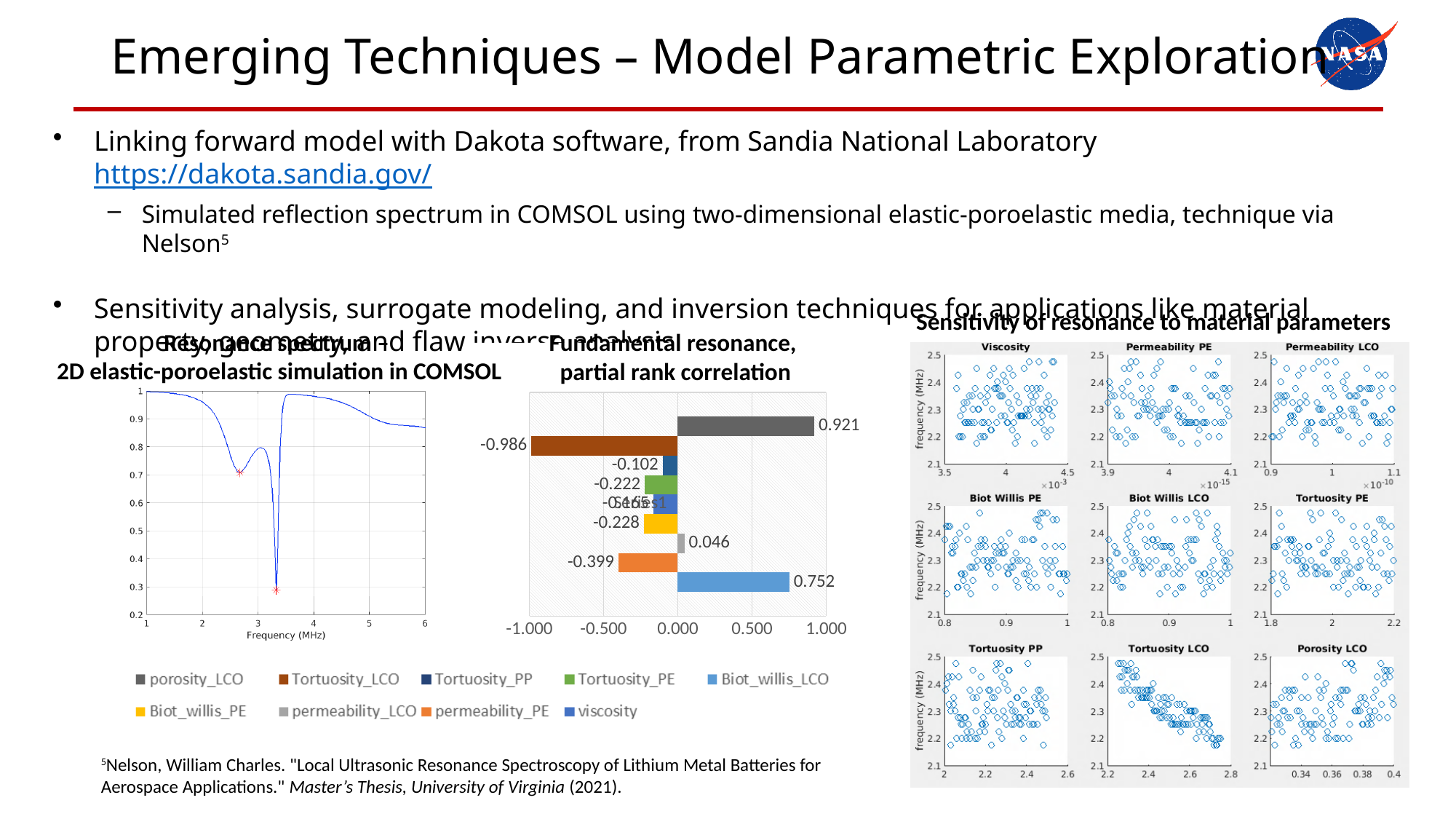
How many series does the legend of the 'Fundamental resonance, partial rank correlation' chart list? 9 In the 'Fundamental resonance, partial rank correlation' chart, which series has the highest value? porosity_LCO In the 'Sensitivity of resonance to material parameters' panel, how many scatter plots are shown? 9 In the 'Fundamental resonance, partial rank correlation' chart, which is larger: the value for Tortuosity_PP or the value for permeability_PE? Tortuosity_PP In the 'Fundamental resonance, partial rank correlation' chart, what is the value for permeability_LCO? 0.046 In the 'Fundamental resonance, partial rank correlation' chart, what is the value for porosity_LCO? 0.921 In the 'Fundamental resonance, partial rank correlation' chart, what is the value for permeability_PE? -0.399 In the 'Fundamental resonance, partial rank correlation' chart, what is the difference between the values for porosity_LCO and Biot_willis_LCO? 1.086 In the 'Fundamental resonance, partial rank correlation' chart, which series has the lowest value? Tortuosity_LCO What kind of chart is the 'Fundamental resonance, partial rank correlation' chart? bar chart In the 'Fundamental resonance, partial rank correlation' chart, what is the value for Biot_willis_LCO? -0.165 In the 'Fundamental resonance, partial rank correlation' chart, what is the value for Tortuosity_LCO? -0.986